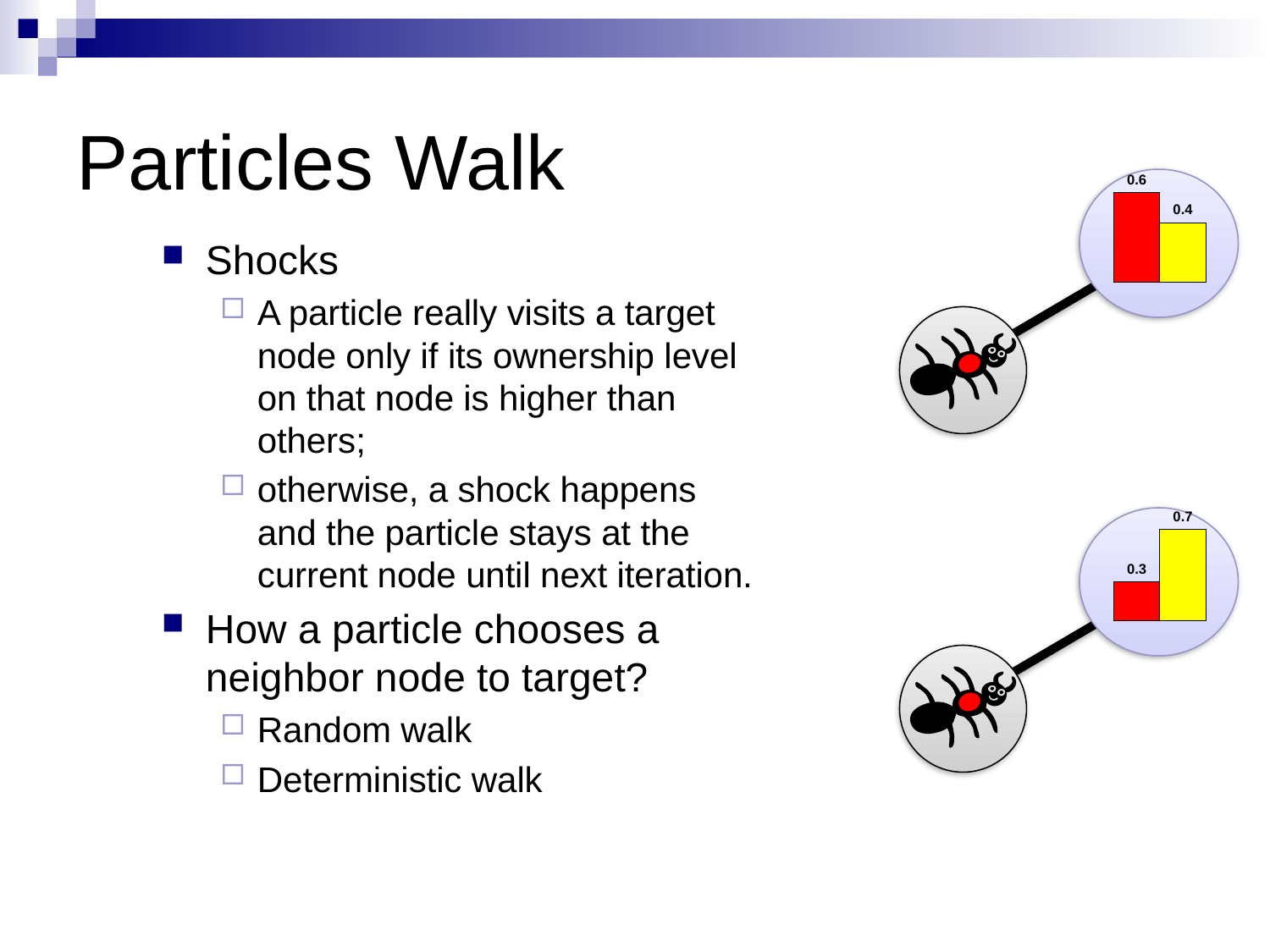
In the top chart on the right of the slide, what is the value of the yellow bar? 0.4 What colours are the two bars in the bottom chart? red and yellow In the bottom chart on the right of the slide, what is the value of the red bar? 0.3 In the top chart, what is the difference between the red bar and the yellow bar? 0.2 How many bars does the top chart show? 2 In the bottom chart, which bar is shorter, the red one or the yellow one? red In the top chart, which bar is taller, the red one or the yellow one? red In the bottom chart on the right of the slide, what is the value of the yellow bar? 0.7 What kind of chart is shown inside each circle on the right of the slide? bar chart Is the red bar in the bottom chart larger or smaller than the red bar in the top chart? smaller In the bottom chart, what is the difference between the yellow bar and the red bar? 0.4 In the top chart on the right of the slide, what is the value of the red bar? 0.6